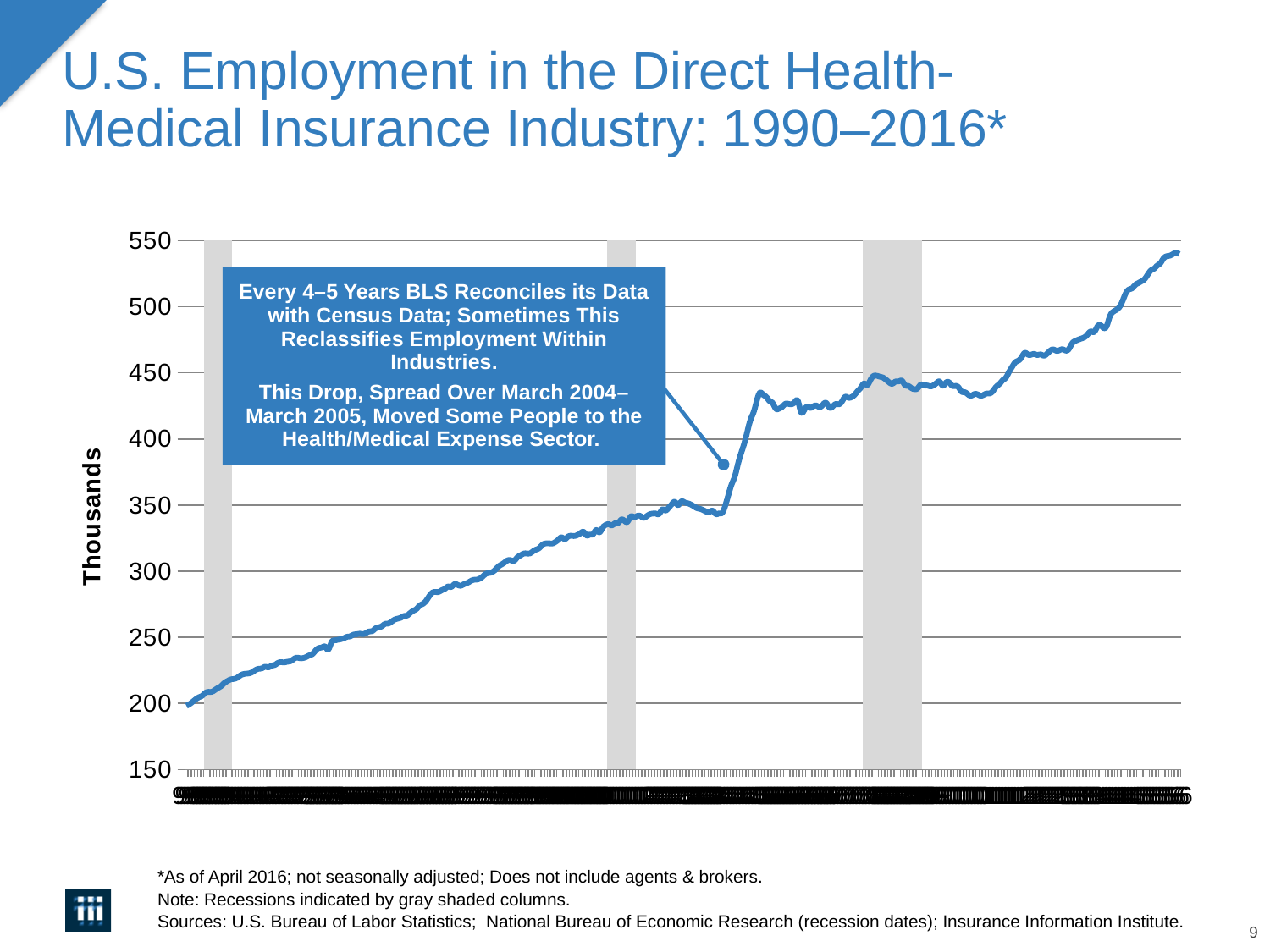
What is the label on the vertical axis of the chart? Thousands Is the value at the start of the line (left end) greater or less than 250? less Is the value at the end of the line (right end) greater or less than 500? greater What is the highest value shown on the vertical axis? 550 Is the highest point on the line greater or less than 500? greater How many data series are plotted on the chart? 1 Overall, do the values rise or fall from the left of the chart to the right? rise Is the value at the right end of the line larger or smaller than the value at the left end? larger What kind of chart is shown on the slide? line chart How many gray shaded recession columns appear on the chart? 3